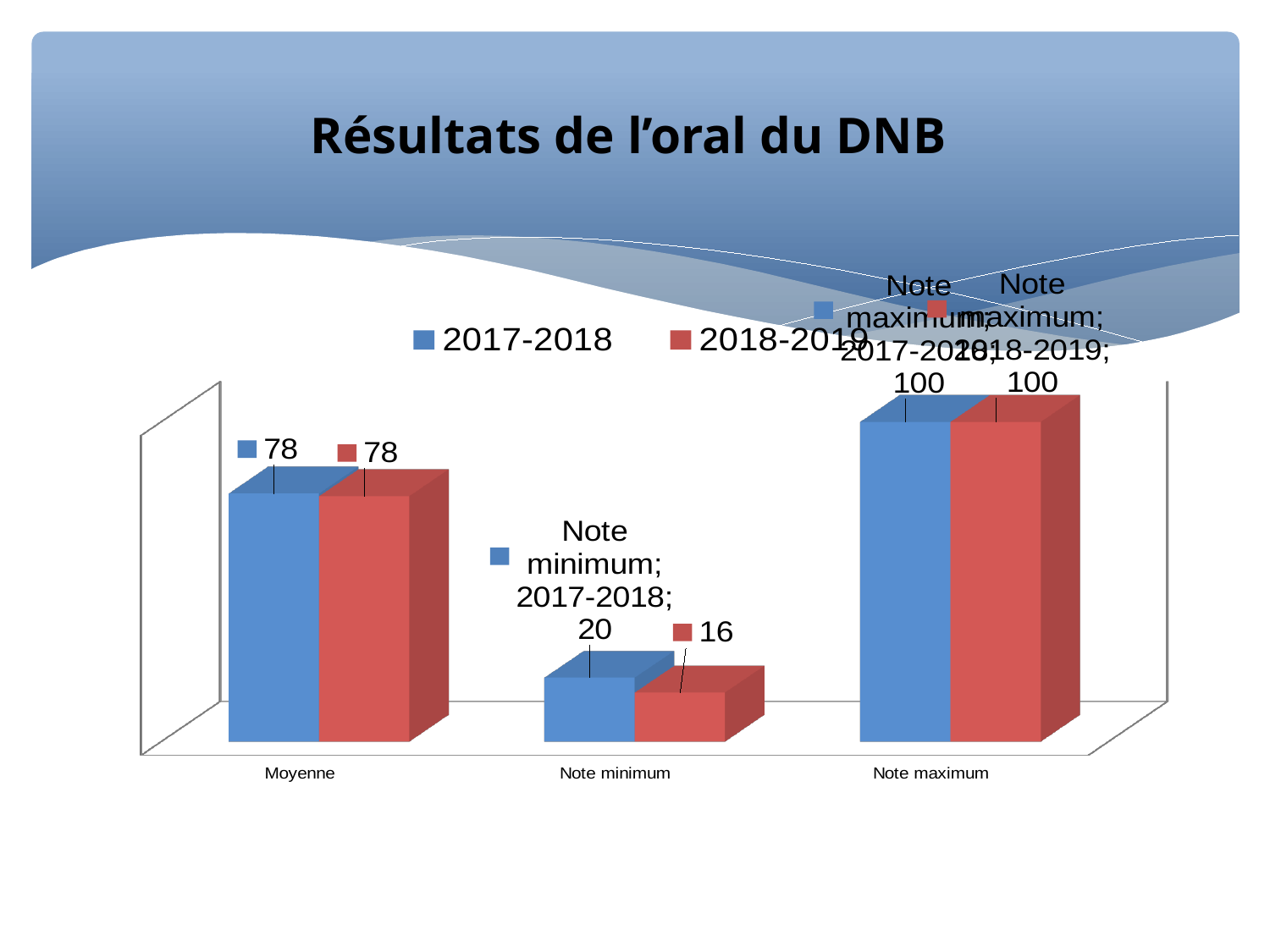
Which category has the lowest value for the 2018-2019 series? Note minimum What is the value for 2017-2018 in the Note minimum category? 20 What is the value for 2018-2019 in the Note minimum category? 16 What is the difference between the 2017-2018 and 2018-2019 values in the Note minimum category? 4 What is the value for 2017-2018 in the Moyenne category? 78 How many categories are shown on the x axis? 3 In the Note minimum category, which series has the larger value, 2017-2018 or 2018-2019? 2017-2018 What kind of chart is shown on the slide? Bar chart How many series does the legend list? 2 What is the title of the slide? Résultats de l'oral du DNB Which category has the highest value for the 2017-2018 series? Note maximum What is the value for 2018-2019 in the Note maximum category? 100